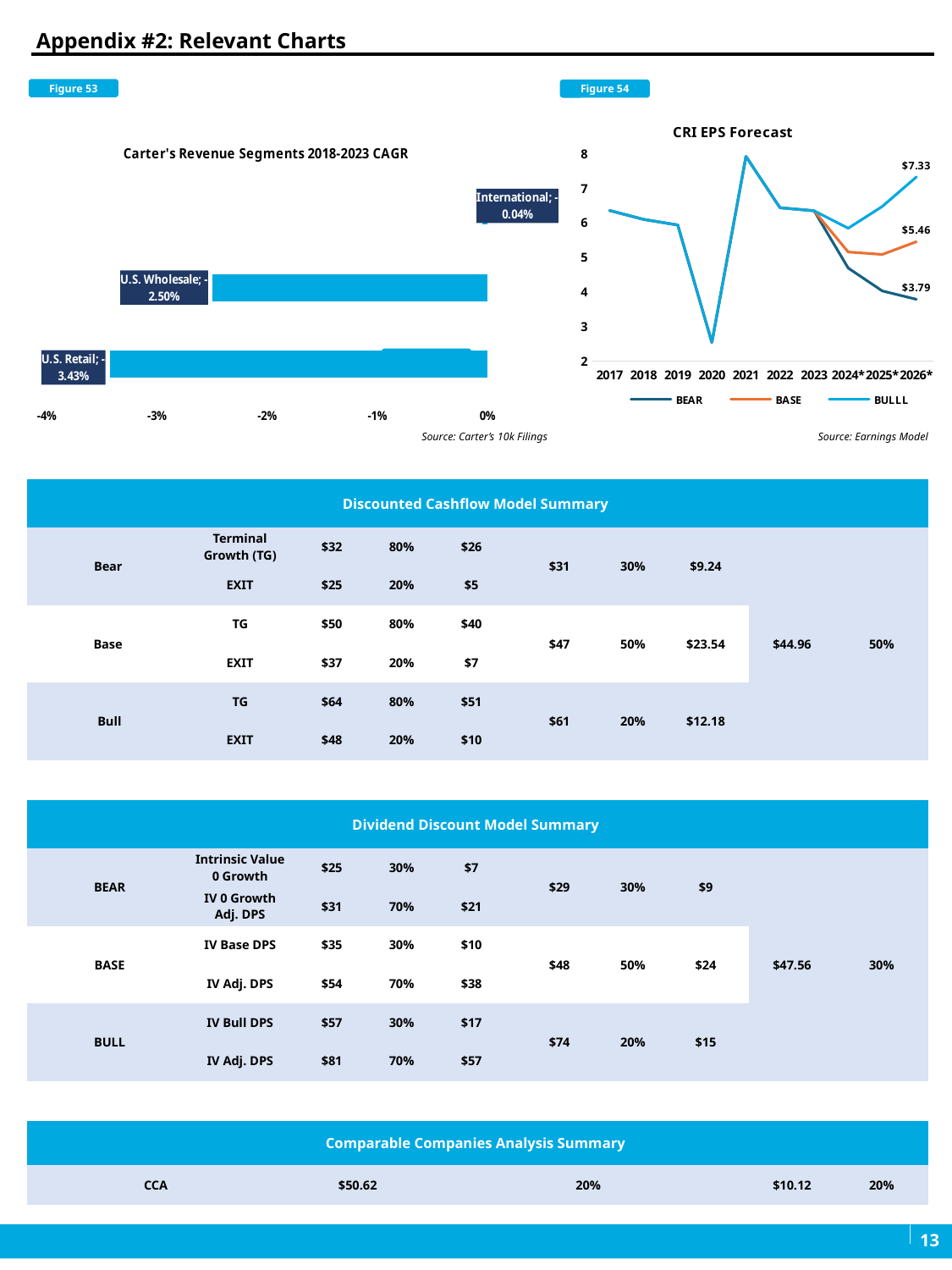
What kind of chart is the Carter's Revenue Segments 2018-2023 CAGR chart? Bar chart In the CRI EPS Forecast chart, what is the BULL value labelled at 2026*? $7.33 In the Carter's Revenue Segments 2018-2023 CAGR chart, what is the CAGR for U.S. Wholesale? -2.50% In the Carter's Revenue Segments 2018-2023 CAGR chart, which segment has the lowest (most negative) CAGR? U.S. Retail In the CRI EPS Forecast chart, is the EPS value for 2020 greater or less than 3? less In the CRI EPS Forecast chart, what is the BEAR value labelled at 2026*? $3.79 In the CRI EPS Forecast chart, what is the BASE value labelled at 2026*? $5.46 In the Carter's Revenue Segments 2018-2023 CAGR chart, which segment has the highest CAGR? International How many series does the legend of the CRI EPS Forecast chart list? 3 In the Carter's Revenue Segments 2018-2023 CAGR chart, how many segments are shown? 3 In the Carter's Revenue Segments 2018-2023 CAGR chart, what is the CAGR for U.S. Retail? -3.43% In the Carter's Revenue Segments 2018-2023 CAGR chart, what is the CAGR for International? -0.04%